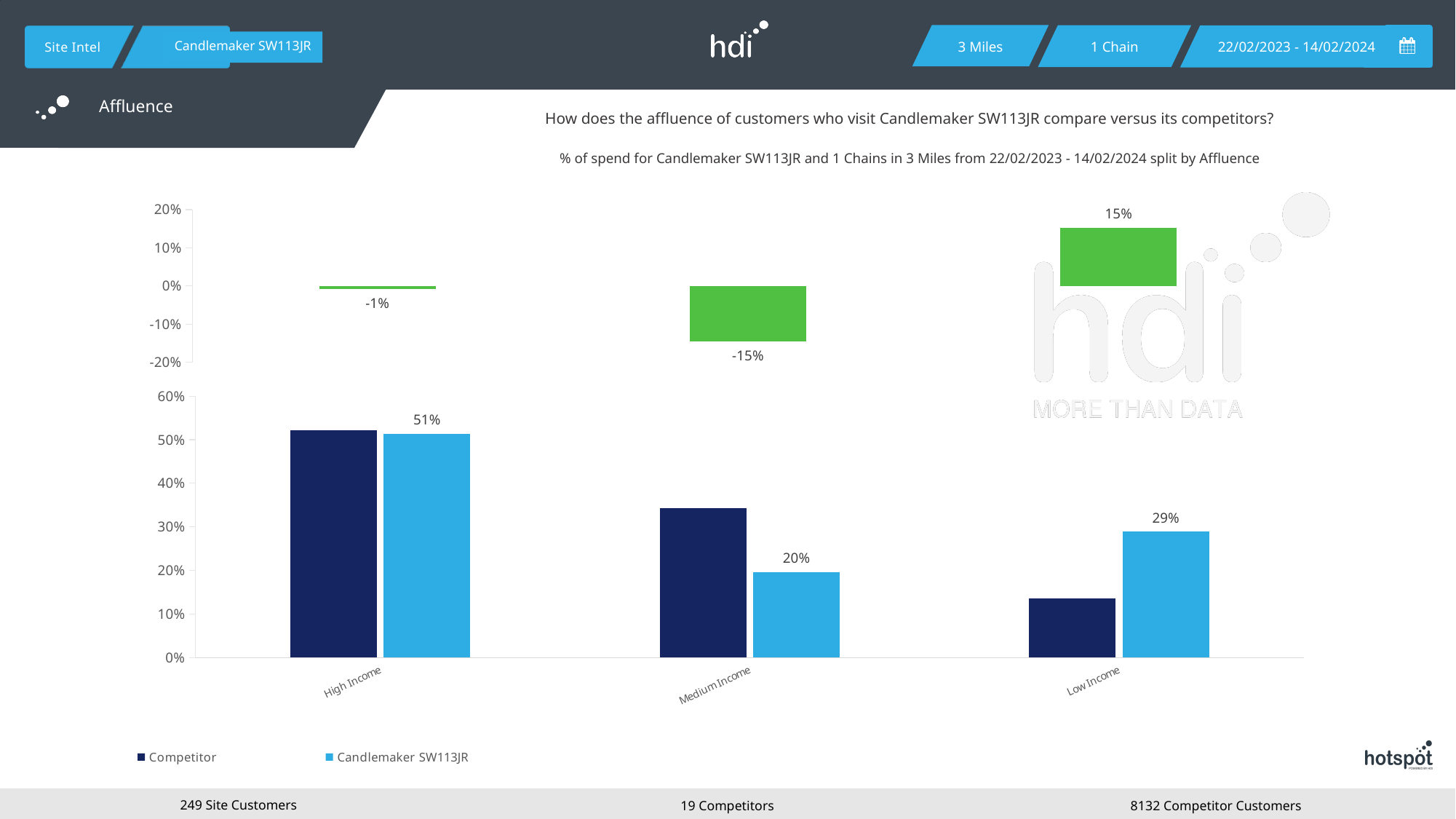
In the bottom bar chart, what is the value for Candlemaker SW113JR in the High Income category? 51% In the top difference chart, what is the value shown for Medium Income? -15% In the bottom bar chart, which is larger for Low Income: the Competitor value or the Candlemaker SW113JR value? Candlemaker SW113JR In the bottom bar chart, what is the difference between the Candlemaker SW113JR values for High Income and Low Income? 22% In the bottom bar chart, which affluence category has the highest value for Candlemaker SW113JR? High Income In the bottom bar chart, is the Competitor value for Medium Income greater or less than 30%? greater In the top difference chart, what is the value shown for Low Income? 15% In the top difference chart, what is the value shown for High Income? -1% How many series does the legend of the bottom bar chart list? 2 In the bottom bar chart, what is the value for Candlemaker SW113JR in the Medium Income category? 20% In the bottom bar chart, what is the value for Candlemaker SW113JR in the Low Income category? 29% In the bottom bar chart, which affluence category has the lowest value for Candlemaker SW113JR? Medium Income